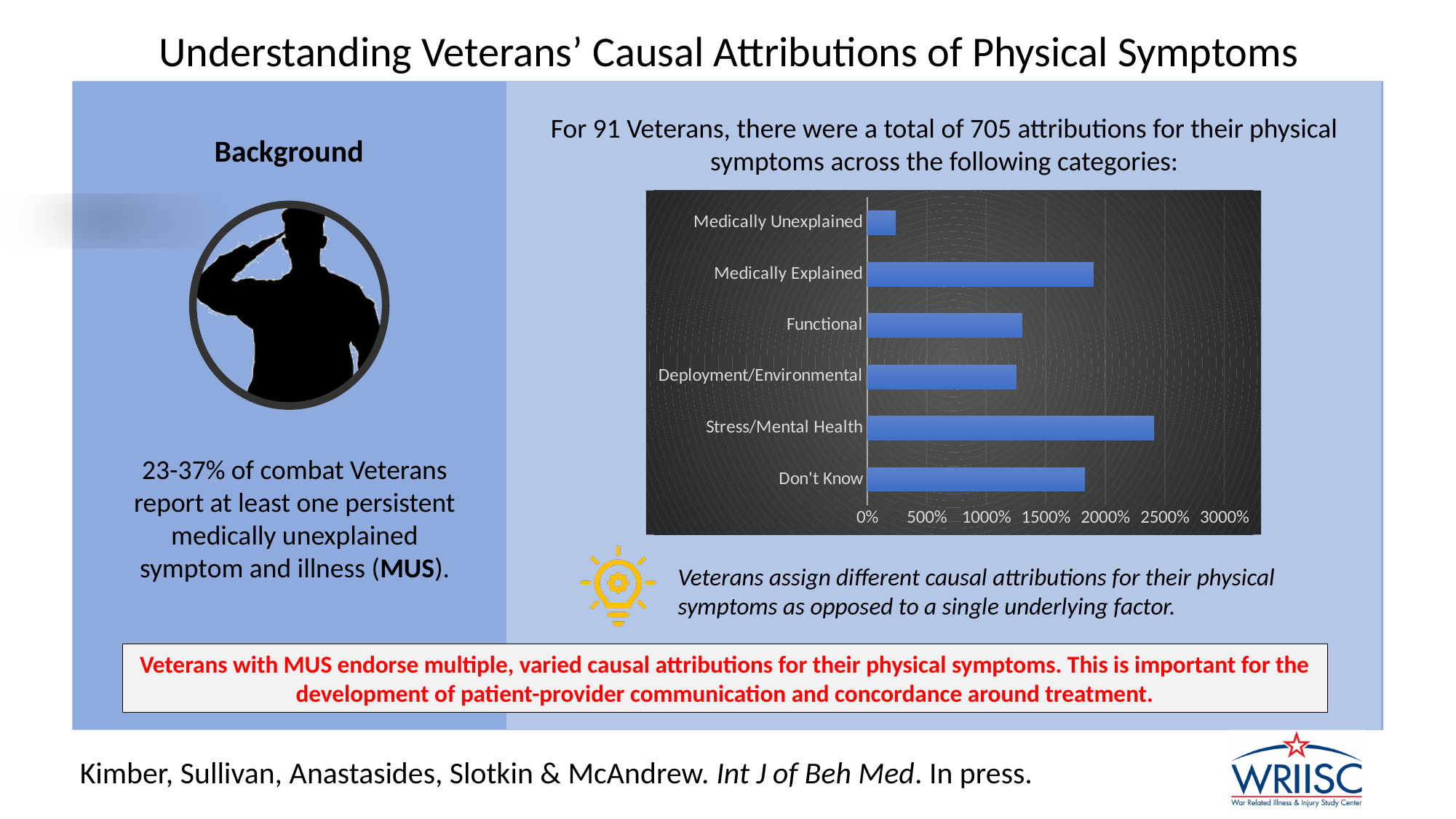
Is the value for Stress/Mental Health greater or less than 2000%? greater Which is larger, the value for Deployment/Environmental or the value for Medically Unexplained? Deployment/Environmental What kind of chart is shown on the slide? bar chart What is the highest tick label shown on the x axis of the bar chart? 3000% Is the value for Functional greater or less than 1000%? greater Is the value for Don't Know greater or less than 1500%? greater Which category has the highest value in the bar chart? Stress/Mental Health How many categories are plotted in the bar chart? 6 Which category has the lowest value in the bar chart? Medically Unexplained Which is larger, the value for Medically Explained or the value for Functional? Medically Explained